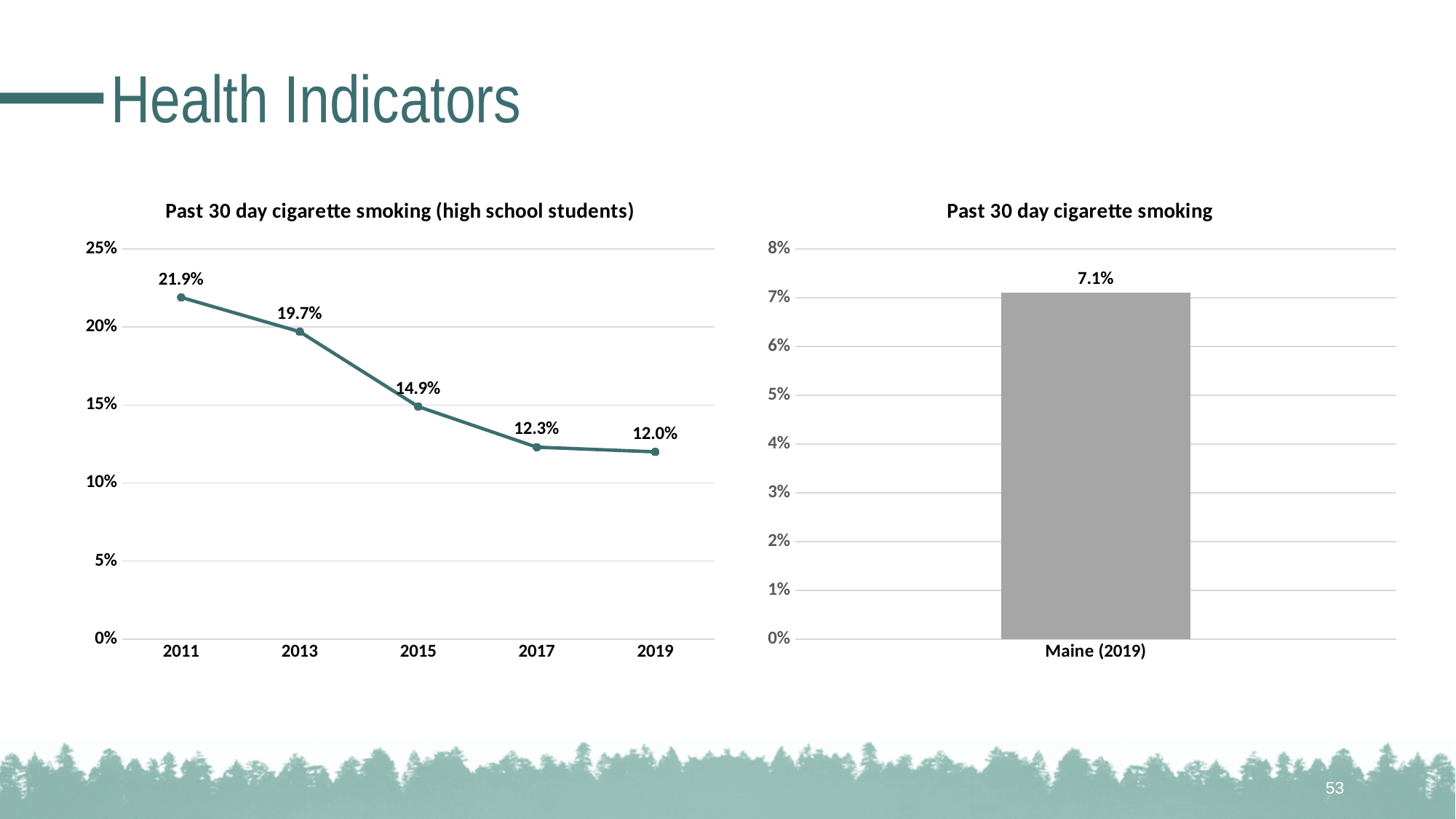
What kind of chart is the 'Past 30 day cigarette smoking (high school students)' chart? line chart In the 'Past 30 day cigarette smoking (high school students)' chart, what is the value for 2015? 14.9% How many data points are plotted in the 'Past 30 day cigarette smoking (high school students)' chart? 5 In the 'Past 30 day cigarette smoking (high school students)' chart, which year has the highest value? 2011 In the 'Past 30 day cigarette smoking (high school students)' chart, what is the value for 2011? 21.9% In the 'Past 30 day cigarette smoking (high school students)' chart, which is larger, the value for 2013 or the value for 2017? 2013 In the 'Past 30 day cigarette smoking (high school students)' chart, what is the difference between the 2011 and 2019 values? 9.9% In the 'Past 30 day cigarette smoking (high school students)' chart, what is the value for 2019? 12.0% In the 'Past 30 day cigarette smoking (high school students)' chart, do the values rise or fall from 2011 to 2019? fall What kind of chart is the 'Past 30 day cigarette smoking' chart on the right? bar chart In the 'Past 30 day cigarette smoking (high school students)' chart, which year has the lowest value? 2019 In the 'Past 30 day cigarette smoking' chart on the right, what is the value for Maine (2019)? 7.1%